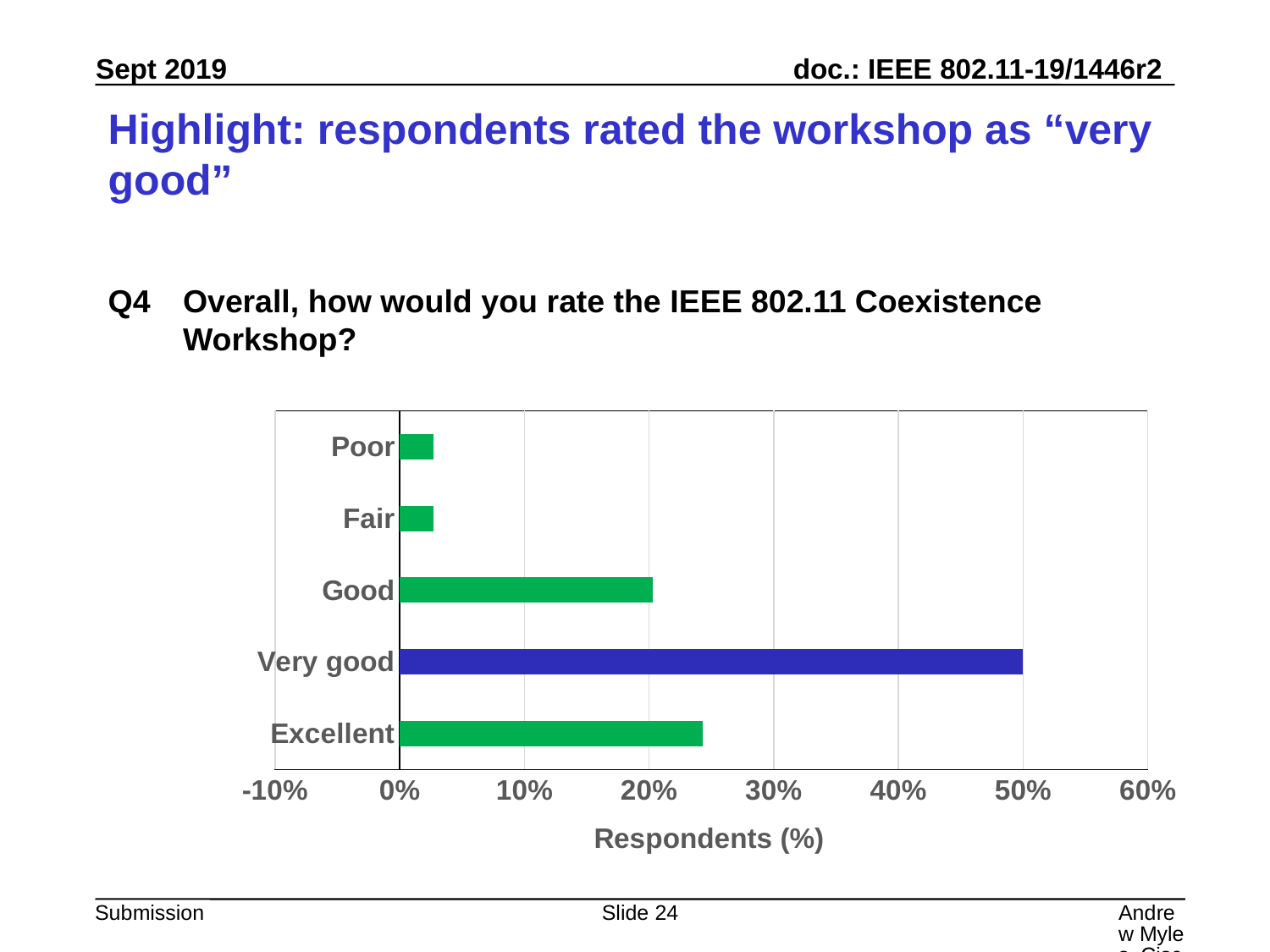
Is the value for "Good" greater or less than 30%? less What is the title of the horizontal axis of the chart? Respondents (%) What percentage of respondents rated the workshop as "Very good"? 50% Is the value for "Very good" greater or less than 40%? greater Is the value for "Excellent" greater or less than 20%? greater Which rating category has the highest percentage of respondents? Very good Which has a larger share of respondents, "Excellent" or "Good"? Excellent How many rating categories are shown in the chart? 5 Which rating category's bar is coloured blue rather than green? Very good What kind of chart is shown on the slide? bar chart Which has a larger share of respondents, "Very good" or "Excellent"? Very good